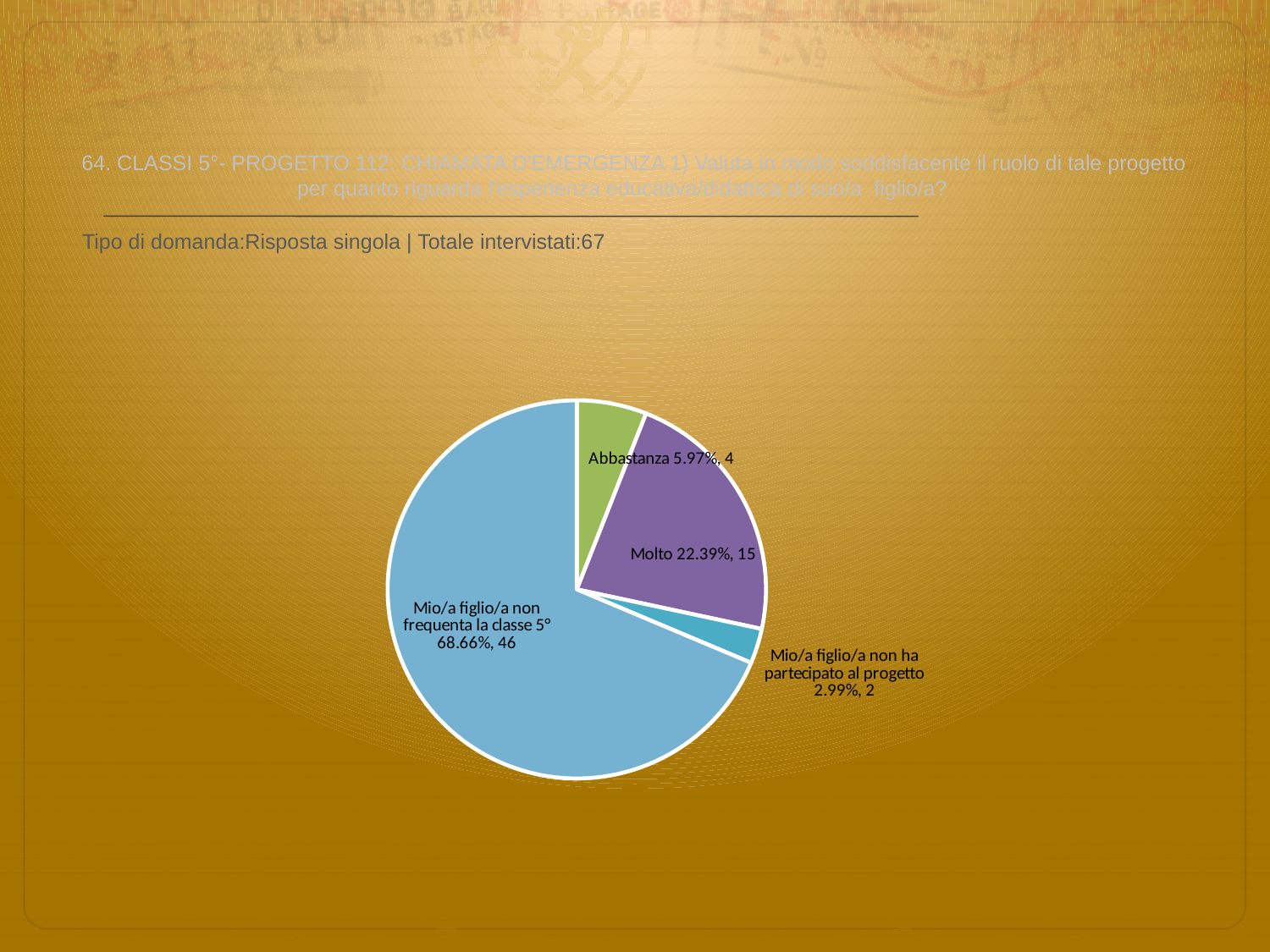
What is the count for the "Molto" slice? 15 What is the total number of respondents across all slices? 67 How many slices does the pie chart have? 4 What percentage share does the "Abbastanza" slice have? 5.97% Which has a larger count, "Molto" or "Abbastanza"? Molto What is the count for the "Mio/a figlio/a non frequenta la classe 5°" slice? 46 What is the difference in count between "Molto" and "Abbastanza"? 11 Which slice is the largest? Mio/a figlio/a non frequenta la classe 5° What percentage share does the "Mio/a figlio/a non ha partecipato al progetto" slice have? 2.99% What kind of chart is shown on the slide? pie chart What colour is the "Molto" slice? purple Which slice is the smallest? Mio/a figlio/a non ha partecipato al progetto